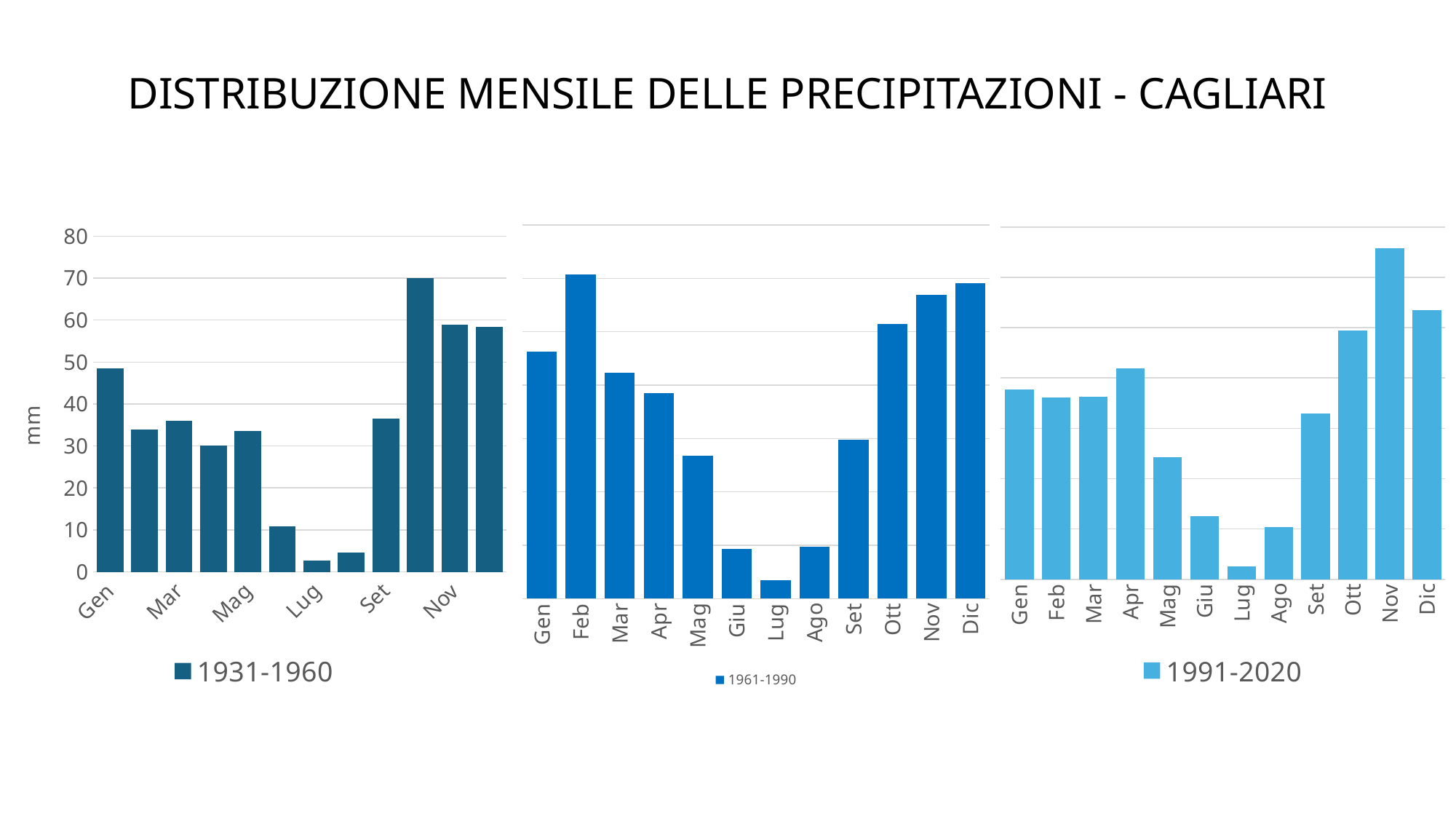
In the middle chart (1961-1990), which month has the highest precipitation? Feb In the left chart (1931-1960), is the value for Ott greater or less than 60? greater What is the label on the vertical axis of the left chart? mm How many months (bars) are plotted in the right chart (1991-2020)? 12 In the left chart (1931-1960), which month has the lowest precipitation? Lug How many series does the legend of the middle chart list? 1 In the left chart (1931-1960), is the value for Gen greater or less than 40? greater In the right chart (1991-2020), which is larger, the value for Ott or the value for Dic? Dic What kind of chart is the left chart (1931-1960)? bar chart In the right chart (1991-2020), which month has the highest precipitation? Nov In the left chart (1931-1960), which month has the highest precipitation? Ott In the right chart (1991-2020), which month has the lowest precipitation? Lug